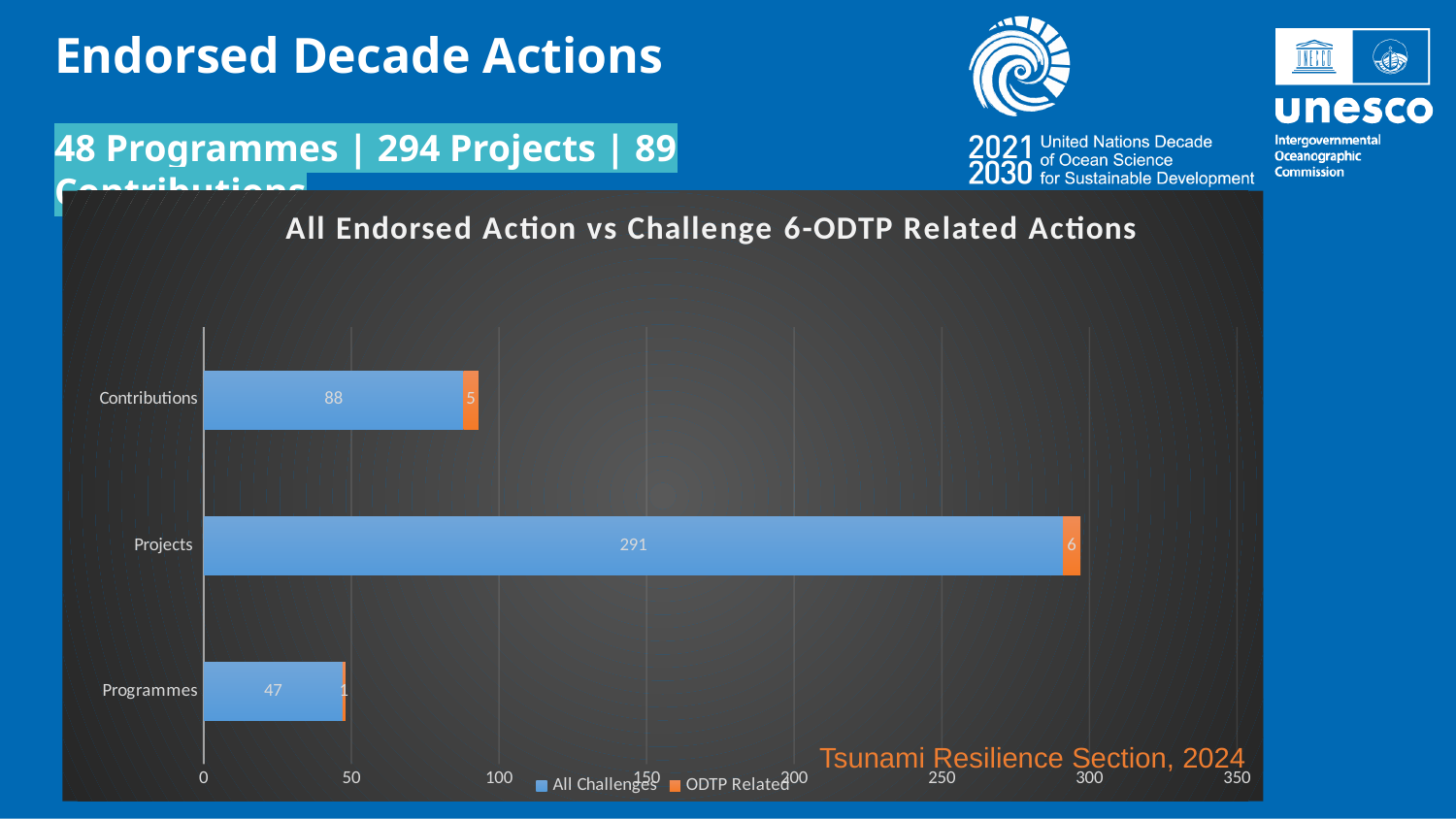
How many categories are shown on the chart? 3 Is the All Challenges value for Contributions greater or less than 100? less What is the All Challenges value for Programmes? 47 What is the difference between the All Challenges values for Contributions and Programmes? 41 What is the total of the stacked bar for Projects? 297 Which category has the lowest ODTP Related value? Programmes What is the title of the chart? All Endorsed Action vs Challenge 6-ODTP Related Actions Which category has the highest All Challenges value? Projects What type of chart is shown on the slide? bar chart What is the ODTP Related value for Contributions? 5 How many series does the chart legend list? 2 What is the All Challenges value for Projects? 291